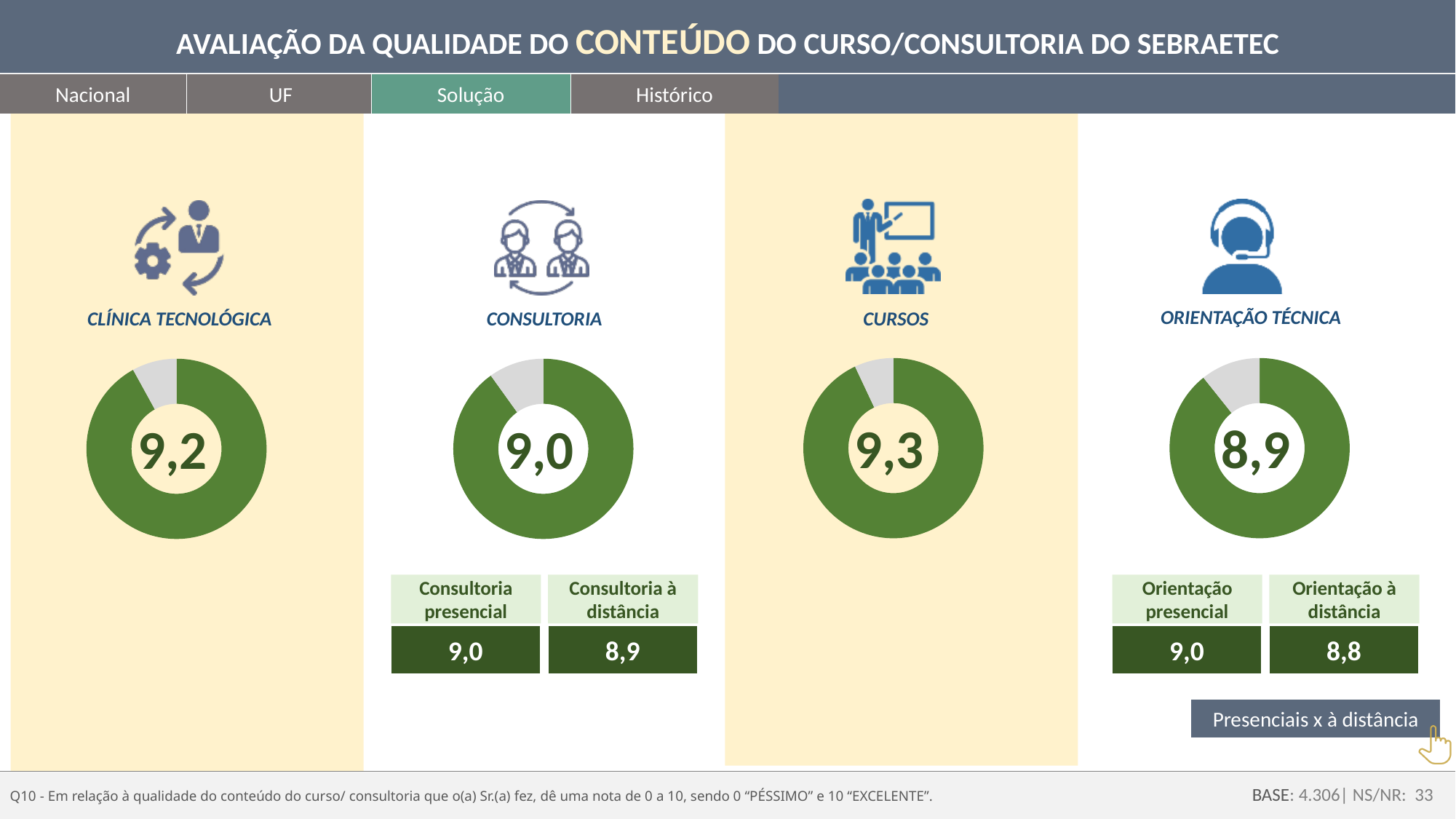
What type of chart is used to display the score for each solution on the slide? Donut chart Which has the higher score in its donut chart, CLÍNICA TECNOLÓGICA or CONSULTORIA? CLÍNICA TECNOLÓGICA Among the four donut charts on the slide, which solution has the lowest score? ORIENTAÇÃO TÉCNICA What value is shown in the centre of the CURSOS donut chart? 9,3 Below the ORIENTAÇÃO TÉCNICA donut chart, what is the difference between the Orientação presencial and Orientação à distância scores? 0,2 What value is shown in the centre of the CONSULTORIA donut chart? 9,0 What value is shown in the centre of the ORIENTAÇÃO TÉCNICA donut chart? 8,9 What is the difference between the CURSOS score and the ORIENTAÇÃO TÉCNICA score shown in the donut charts? 0,4 How many donut charts are shown on the slide? 4 What value is shown in the centre of the CLÍNICA TECNOLÓGICA donut chart? 9,2 Among the four donut charts on the slide, which solution has the highest score? CURSOS Below the CONSULTORIA donut chart, what score is shown for Consultoria à distância? 8,9